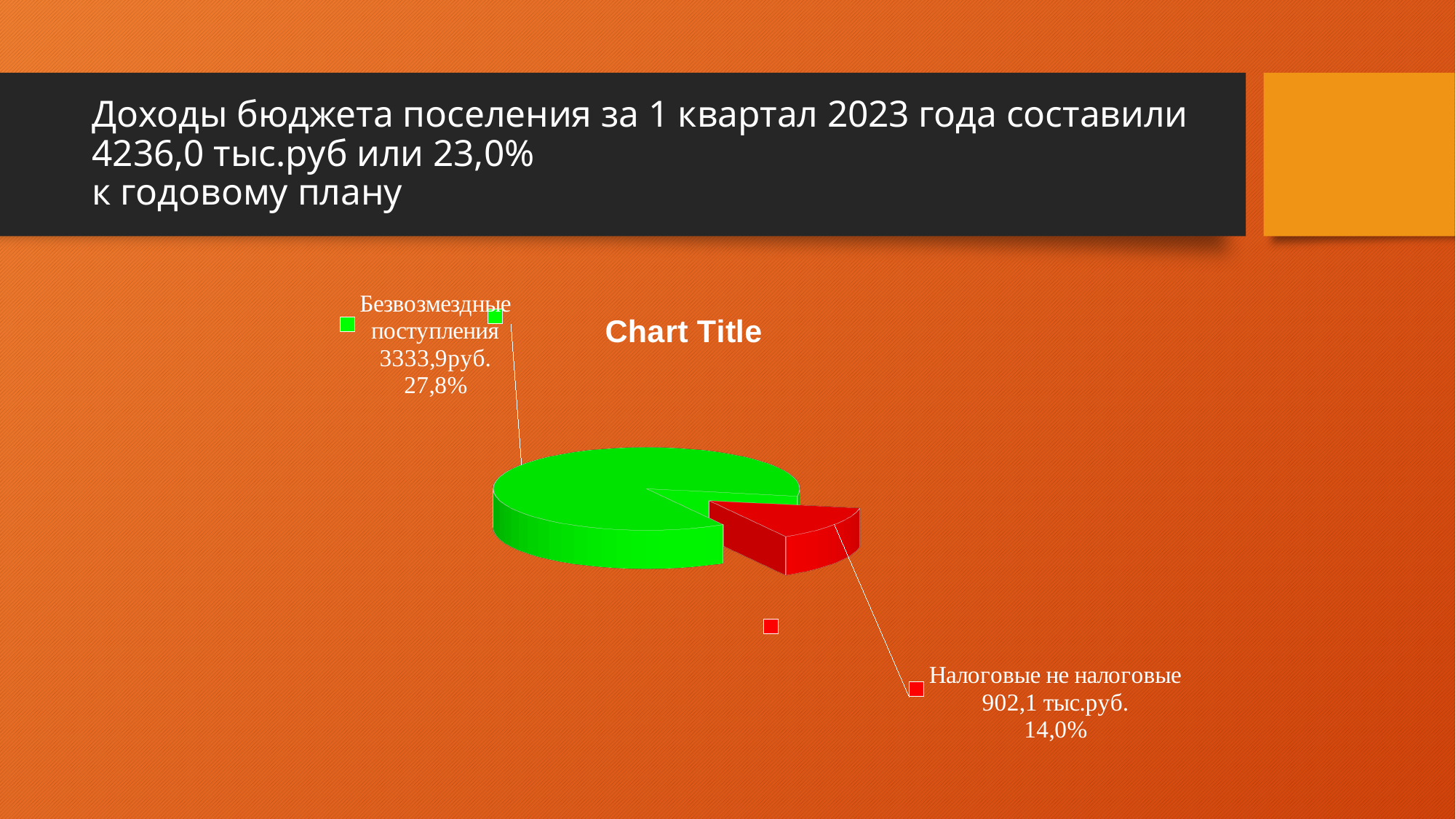
What value is printed for the slice "Безвозмездные поступления"? 3333,9руб. Which is larger, the value for "Безвозмездные поступления" or the value for "Налоговые не налоговые"? Безвозмездные поступления Which slice of the pie chart is the smallest? Налоговые не налоговые How many slices does the pie chart have? 2 What percentage is printed in the label for "Налоговые не налоговые"? 14,0% Which slice of the pie chart is the largest? Безвозмездные поступления What percentage is printed in the label for "Безвозмездные поступления"? 27,8% What colour is the slice for "Налоговые не налоговые"? red What value is printed for the slice "Налоговые не налоговые"? 902,1 тыс.руб. What is the difference between the value for "Безвозмездные поступления" (3333,9) and the value for "Налоговые не налоговые" (902,1)? 2431,8 What kind of chart is shown on the slide? pie chart What is the title shown above the pie chart? Chart Title